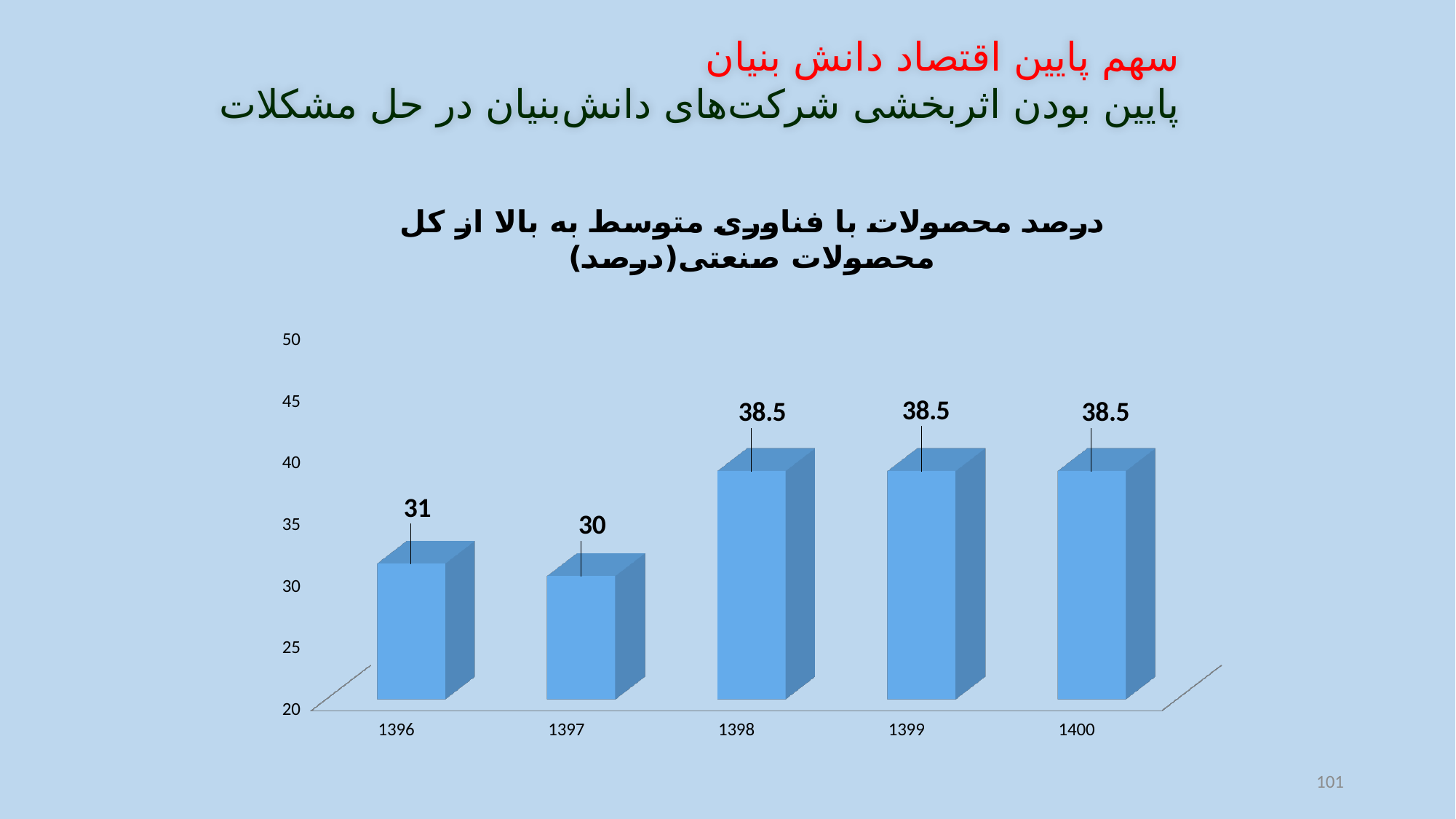
What is the difference between the values for 1398 and 1397? 8.5 Which is larger, the value for 1396 or the value for 1399? 1399 Which year has the lowest value? 1397 How many years are shown on the x axis? 5 Is the value for 1399 greater or less than 35? greater What kind of chart is shown on the slide? bar chart What is the value for 1398? 38.5 What is the value for 1396? 31 What is the value for 1397? 30 What is the difference between the values for 1396 and 1397? 1 Do the values rise or fall from 1397 to 1398? rise What is the value for 1400? 38.5